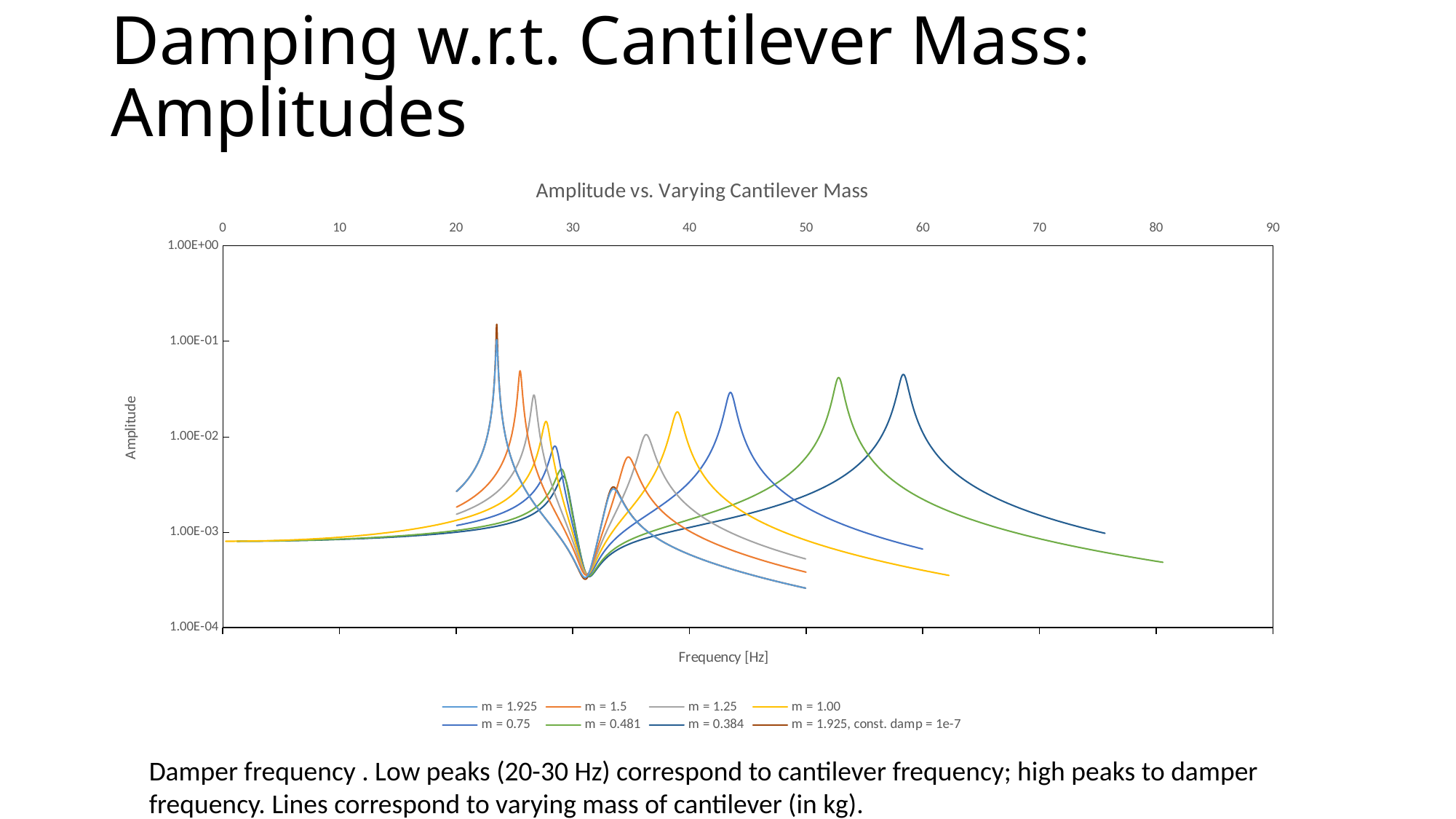
What kind of chart is shown on the slide? line chart What is the lowest tick value shown on the y axis? 1.00E-04 How many series does the chart legend list? 8 Is the minimum amplitude of the curves near 31 Hz greater or less than 1.00E-03? less Is the peak amplitude of the m = 0.384 series greater or less than 1.00E-02? greater What is the title of the chart? Amplitude vs. Varying Cantilever Mass Is the peak amplitude of the m = 1.00 series greater or less than 1.00E-01? less Which has the higher peak amplitude, the m = 0.384 series or the m = 1.00 series? m = 0.384 What is the label of the x axis? Frequency [Hz] Which series has its high (damper) peak at the highest frequency? m = 0.384 What is the highest tick value shown on the x axis? 90